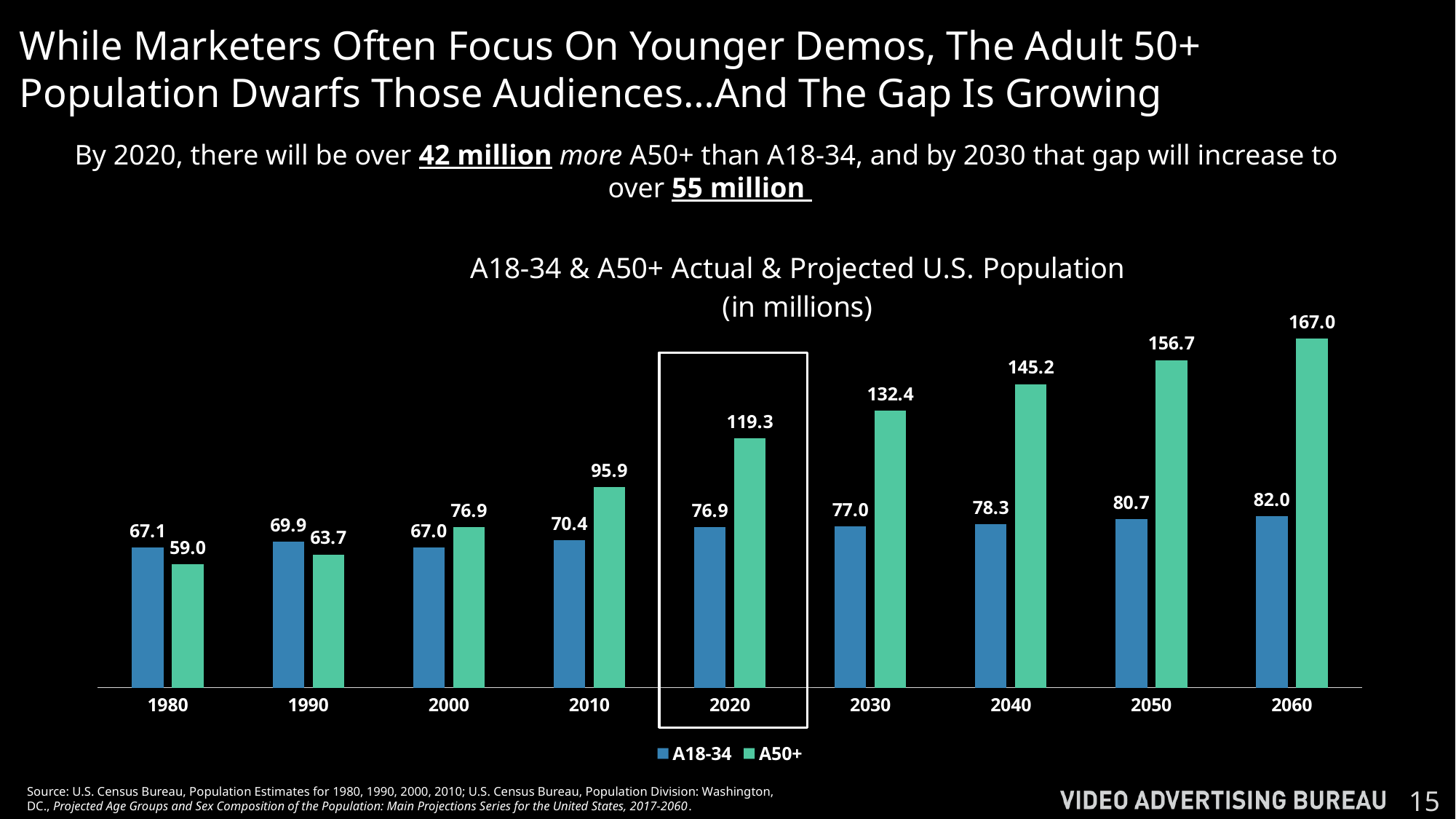
Which year has the lowest A50+ value? 1980 Does the A50+ series rise or fall from 1980 to 2060? Rise What kind of chart is shown? Bar chart Which year has the highest A50+ value? 2060 What is the A50+ value for 2020? 119.3 What is the difference between the A50+ and A18-34 values in 2030? 55.4 How many series does the legend list? 2 What is the A50+ value for 2060? 167.0 What is the A18-34 value for 1990? 69.9 In 1980, which is larger: A18-34 or A50+? A18-34 What is the title of the chart? A18-34 & A50+ Actual & Projected U.S. Population (in millions) How many years are shown on the x axis? 9